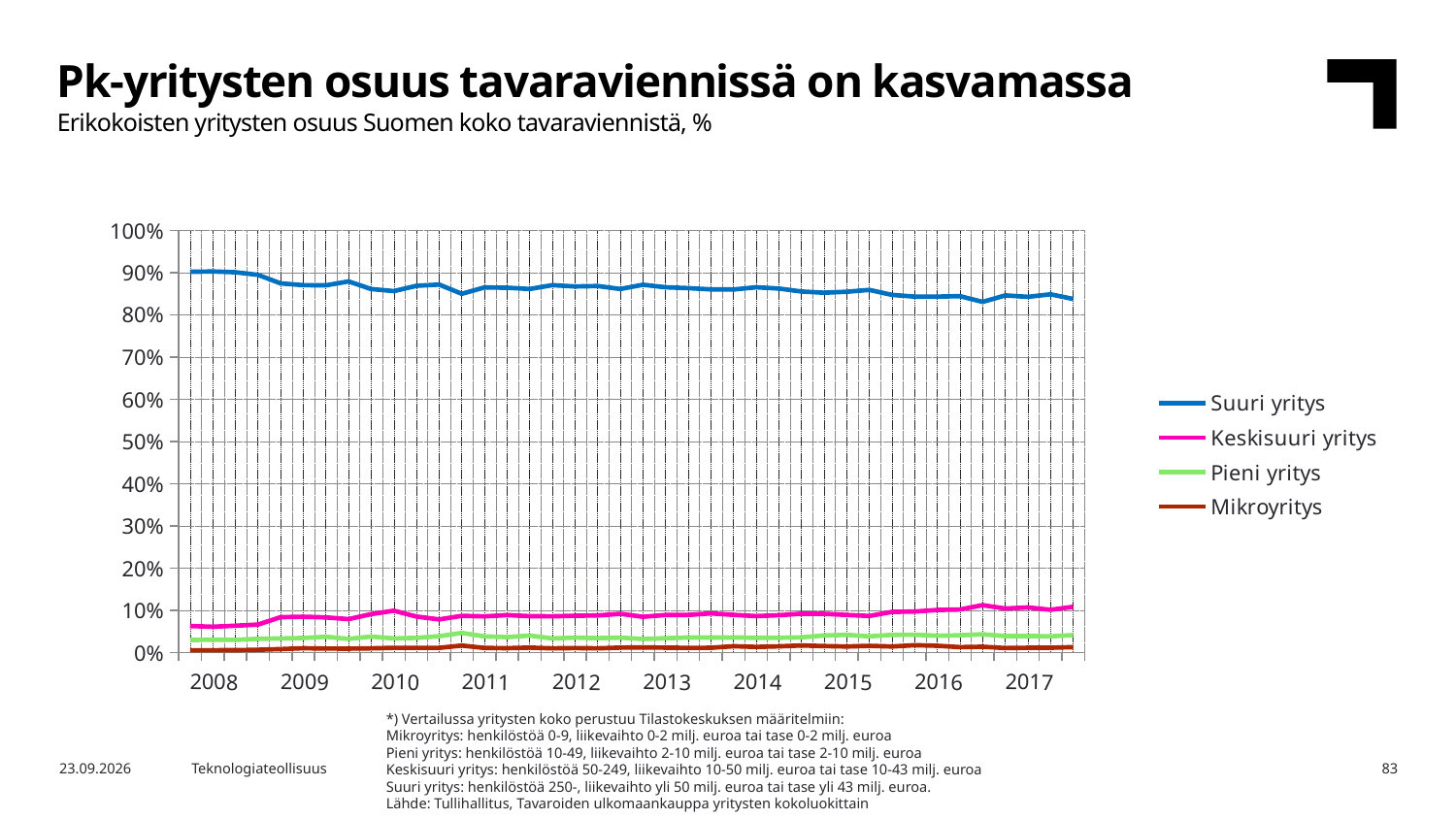
Is the value for Suuri yritys at the end of 2017 greater or less than 90%? less Which series has the lowest share of exports throughout the period? Mikroyritys Does the share for Keskisuuri yritys rise or fall from 2008 to 2017? rise What colour is the line for Suuri yritys? blue How many years are labelled on the x axis? 10 In 2017, which is larger: the share for Keskisuuri yritys or for Pieni yritys? Keskisuuri yritys Is the value for Suuri yritys at the start of 2008 greater or less than 80%? greater How many series does the legend list? 4 Is the value for Keskisuuri yritys in 2017 greater or less than 20%? less What kind of chart is shown on the slide? line chart Does the share for Suuri yritys rise or fall from 2008 to 2017? fall Which series has the highest share of exports throughout the period? Suuri yritys